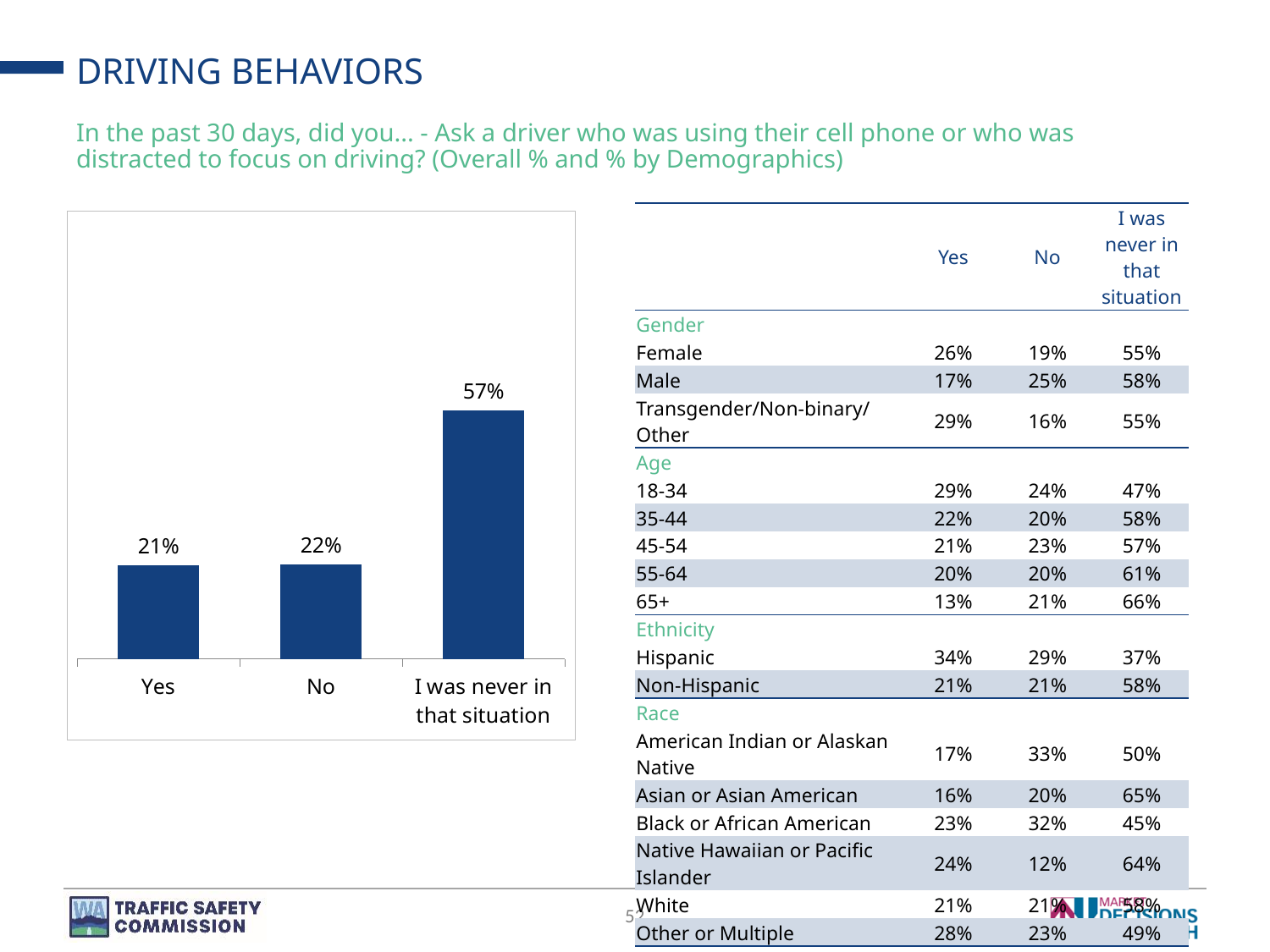
What is the value for "Yes" in the bar chart? 21% How many categories are shown in the bar chart? 3 What kind of chart is shown on the left of the slide? Bar chart What is the value for "No" in the bar chart? 22% What is the value for "I was never in that situation" in the bar chart? 57% Which category has the highest value in the bar chart? I was never in that situation Do the values in the bar chart rise or fall from left to right? Rise In the bar chart, which is larger: the value for "Yes" or the value for "I was never in that situation"? I was never in that situation What is the difference between the values for "No" and "Yes" in the bar chart? 1% What is the total of the three values shown in the bar chart? 100% What is the difference between the values for "I was never in that situation" and "No" in the bar chart? 35% Which category has the lowest value in the bar chart? Yes